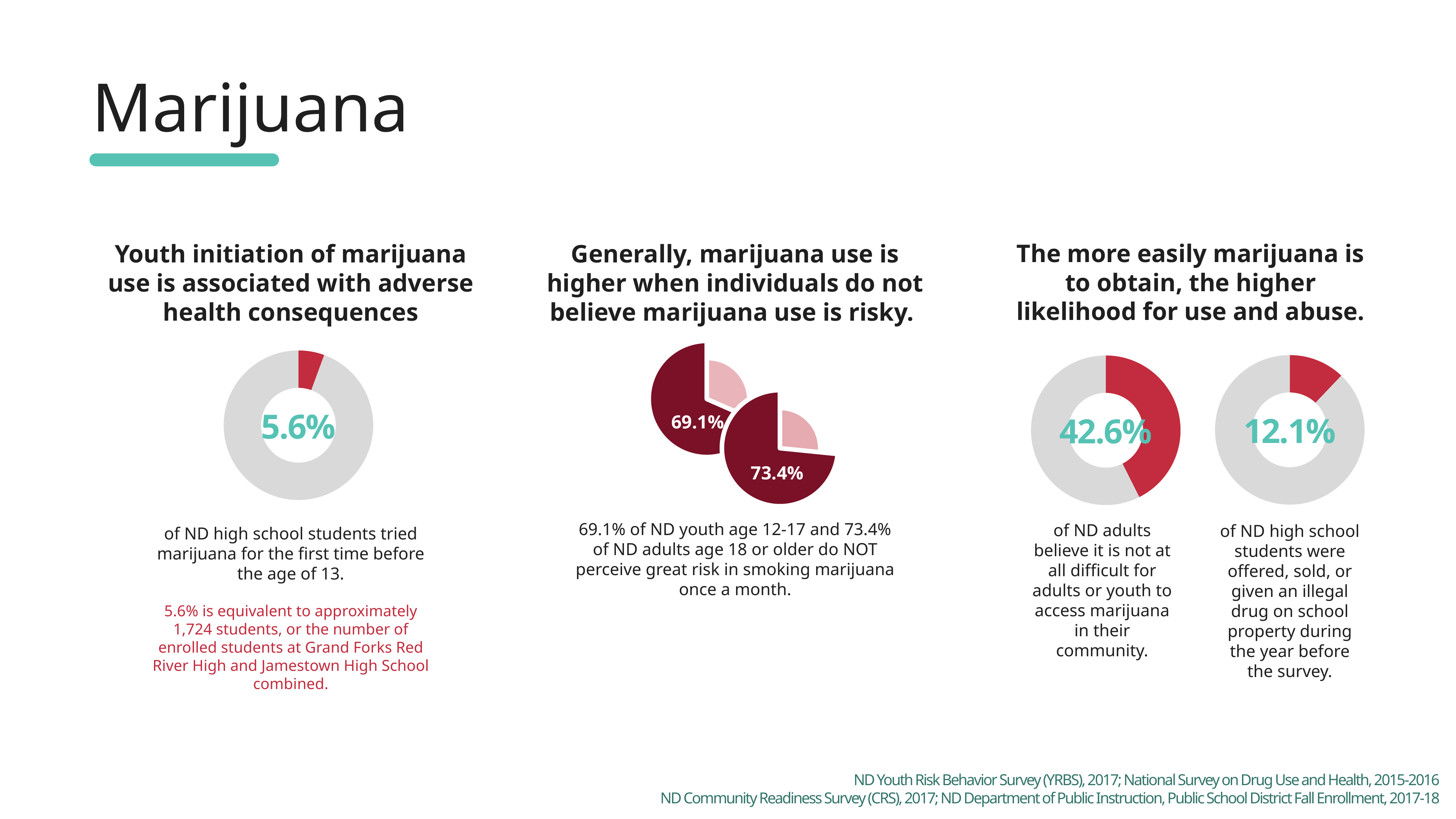
What type of charts are used to show the 69.1% and 73.4% values in the middle of the slide? Pie charts Across all the charts on the slide, which chart shows the smallest percentage value? The 5.6% donut chart (ND high school students who tried marijuana before age 13) What is the difference between the 42.6% and 12.1% values shown in the two donut charts on the right side of the slide? 30.5 percentage points In the middle pie charts, what percentage of ND youth age 12-17 do NOT perceive great risk in smoking marijuana once a month? 69.1% In the middle pie charts, what is the difference in percentage points between the ND adults (73.4%) and ND youth (69.1%) who do NOT perceive great risk in smoking marijuana once a month? 4.3 percentage points On the left donut chart under 'Youth initiation of marijuana use is associated with adverse health consequences', what percentage of ND high school students tried marijuana for the first time before the age of 13? 5.6% What type of chart is used to show the 5.6% value on the left side of the slide? Donut chart On the right side of the slide, what percentage of ND high school students were offered, sold, or given an illegal drug on school property during the year before the survey? 12.1% On the right side of the slide, what percentage of ND adults believe it is not at all difficult for adults or youth to access marijuana in their community? 42.6% In the middle pie charts, which group has the larger share not perceiving great risk in smoking marijuana once a month: ND youth age 12-17 or ND adults age 18 or older? ND adults age 18 or older Of the two donut charts on the right side of the slide, which shows the larger value: the ND adults chart or the ND high school students chart? ND adults chart (42.6%) In the middle pie charts, what percentage of ND adults age 18 or older do NOT perceive great risk in smoking marijuana once a month? 73.4%